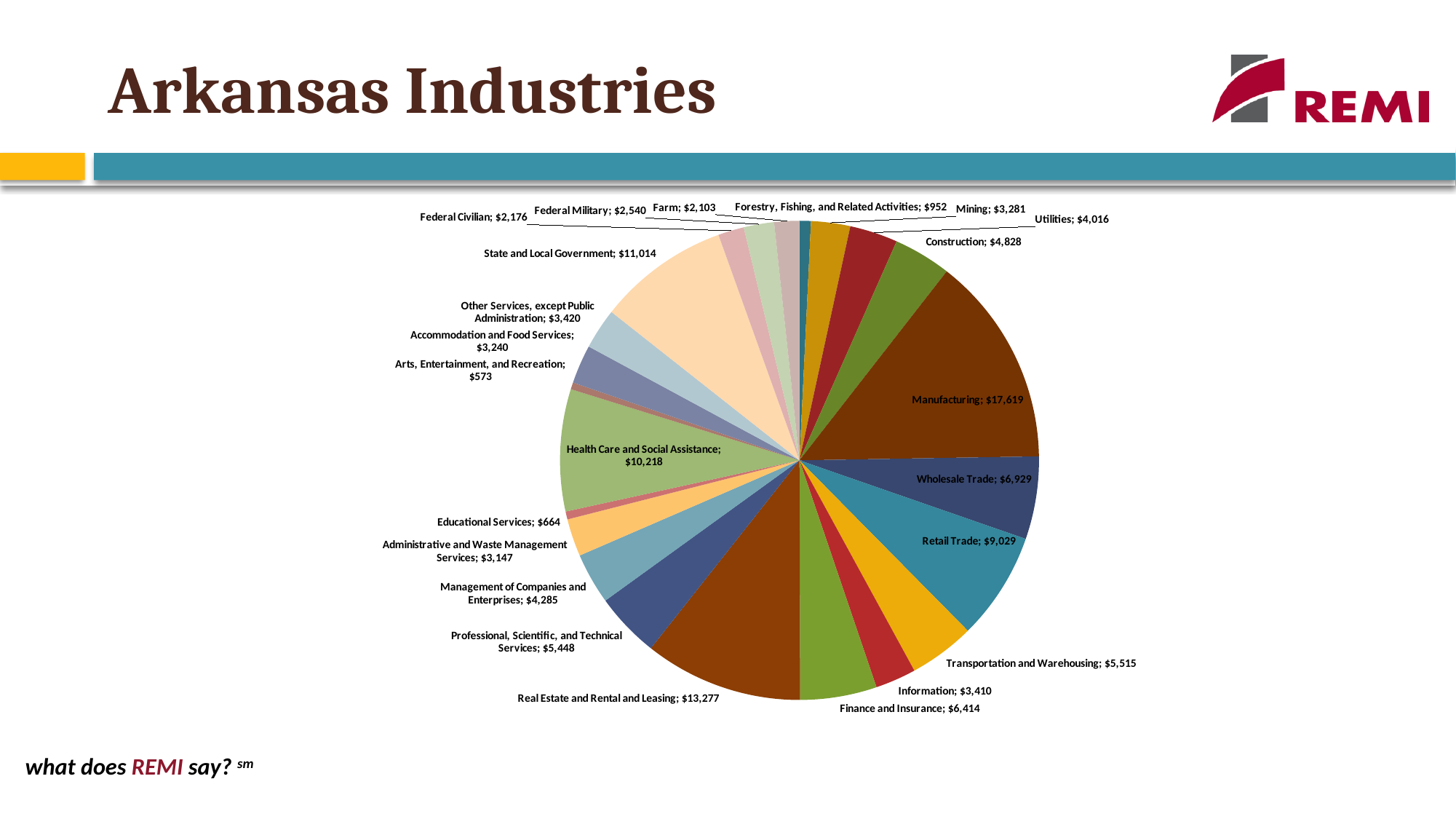
What is the difference between the values for Retail Trade and Wholesale Trade? $2,100 Which industry has the largest slice of the pie? Manufacturing Which industry has the smallest slice of the pie? Arts, Entertainment, and Recreation Which is larger, State and Local Government or Health Care and Social Assistance? State and Local Government What is the value for Manufacturing? $17,619 What is the difference between the values for Manufacturing and Real Estate and Rental and Leasing? $4,342 What is the value for Forestry, Fishing, and Related Activities? $952 How many industries are shown in the pie chart? 23 What type of chart is shown on the slide? Pie chart What is the value for Real Estate and Rental and Leasing? $13,277 What is the title of the slide containing the chart? Arkansas Industries What is the value for Health Care and Social Assistance? $10,218